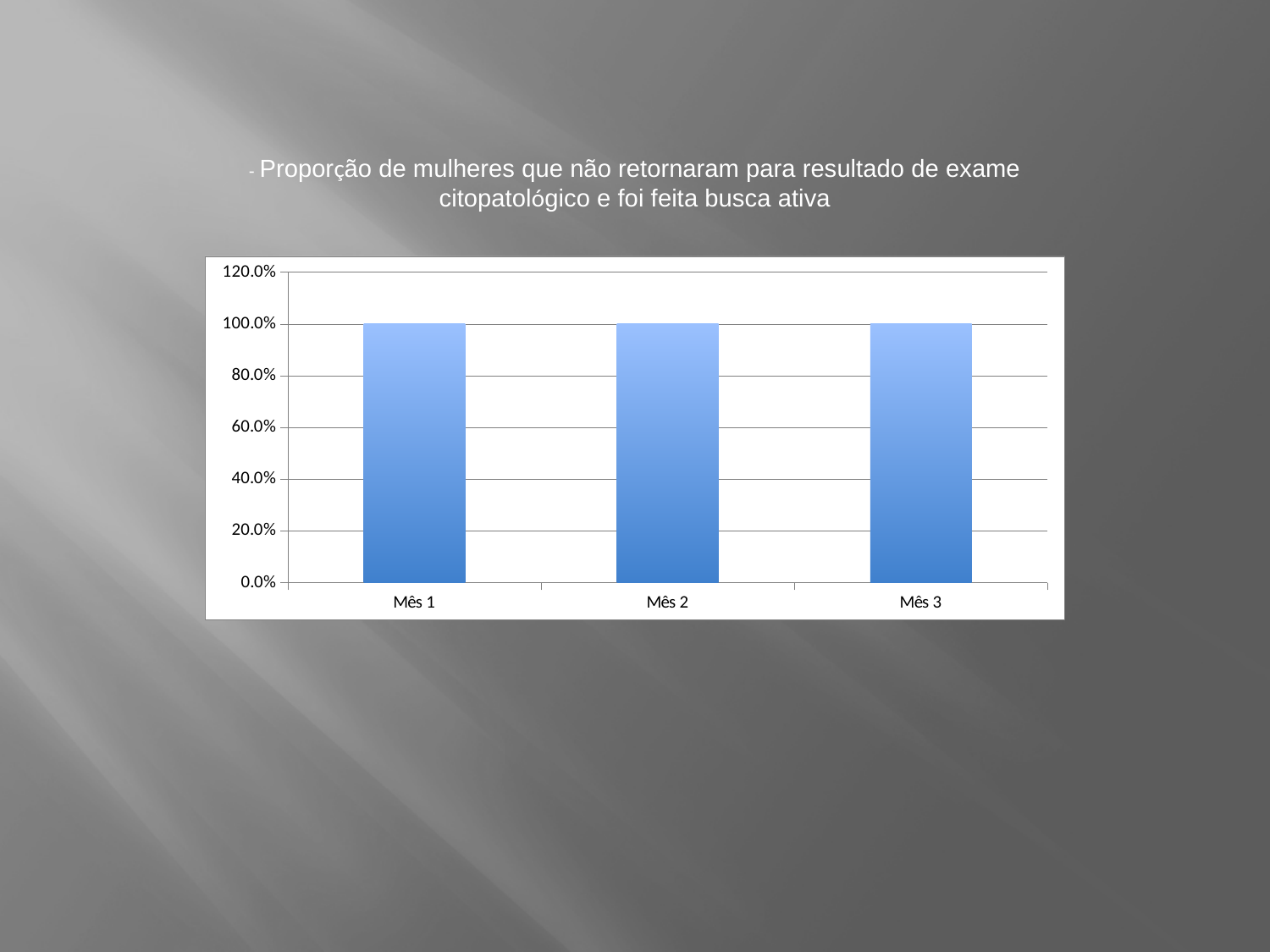
Do the values rise, fall, or stay the same from Mês 1 to Mês 3? stay the same Is the value for Mês 3 greater or less than 120.0%? less What is the highest value shown on the vertical axis? 120.0% What is the value for Mês 3? 100.0% What is the value for Mês 2? 100.0% Is the value for Mês 1 greater or less than 80.0%? greater How many categories are shown on the x axis? 3 What kind of chart is shown on the slide? bar chart What is the value for Mês 1? 100.0% What is the label of the first category on the x axis? Mês 1 What is the difference between the values for Mês 1 and Mês 2? 0.0%